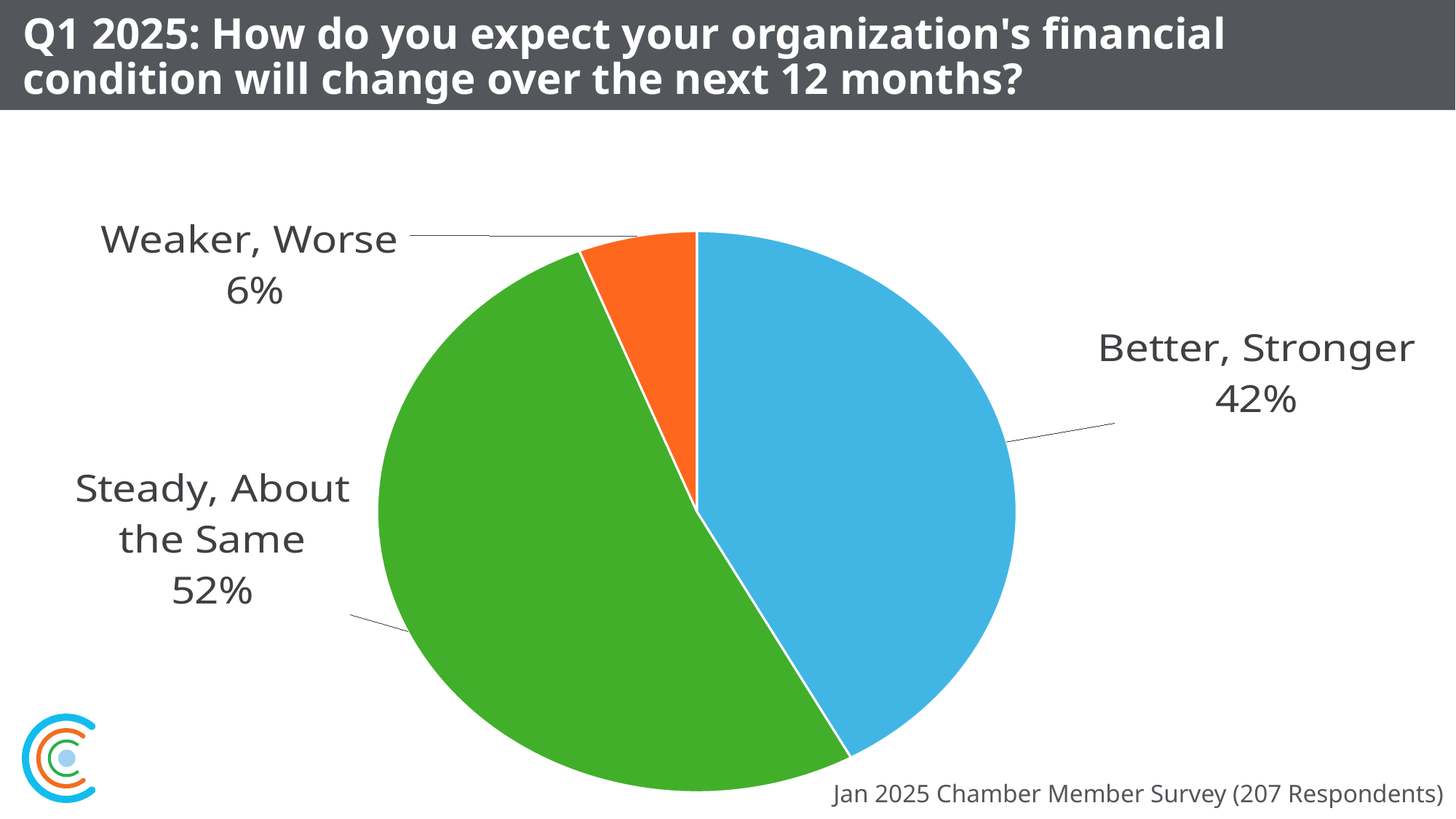
How many slices does the pie chart have? 3 How many percentage points larger is the Steady, About the Same share than the Better, Stronger share? 10 How many respondents took part in the survey, according to the note on the slide? 207 What kind of chart is shown on the slide? Pie chart Which response has the largest share of the pie? Steady, About the Same What share of respondents expect their organization's financial condition to be Weaker, Worse? 6% Which is larger: the share for Better, Stronger or the share for Weaker, Worse? Better, Stronger Which response has the smallest share of the pie? Weaker, Worse What share of respondents expect their organization's financial condition to be Steady, About the Same? 52% What share of respondents expect their organization's financial condition to be Better, Stronger? 42% How many percentage points larger is the Better, Stronger share than the Weaker, Worse share? 36 What colour is the Steady, About the Same slice? Green